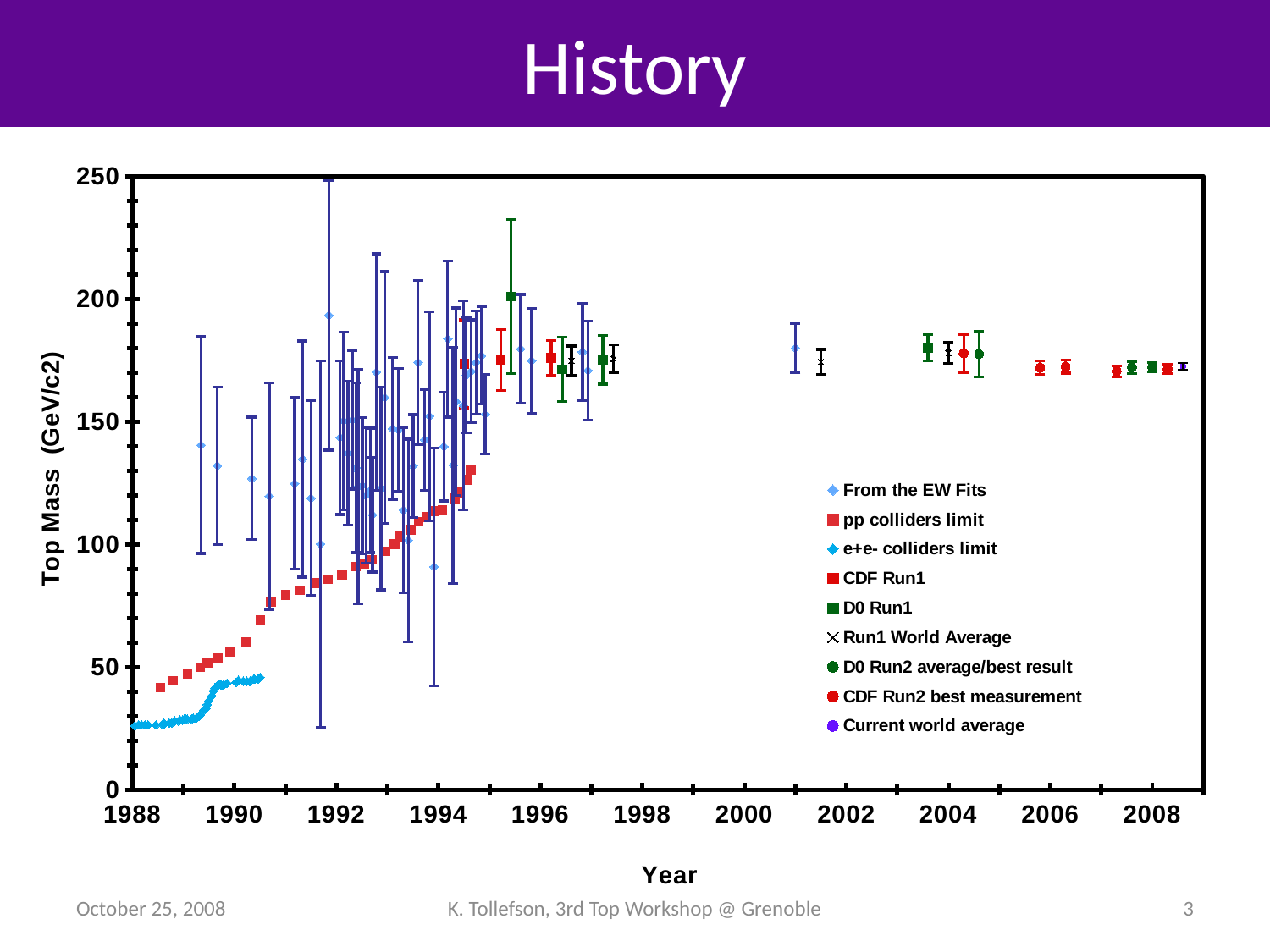
Is the earliest pp colliders limit value (around 1988) greater or less than 50? less Which is larger: the Current world average (around 2008) or the earliest pp colliders limit (around 1988)? Current world average Is the Current world average value (around 2008) greater or less than 150? greater What kind of chart is shown on the slide? scatter chart Is the earliest e+e- colliders limit value (around 1988) greater or less than 50? less What is the label of the vertical axis? Top Mass (GeV/c2) What is the title of the slide containing the chart? History Does the pp colliders limit rise or fall from 1988 to 1994? rise How many series does the legend list? 9